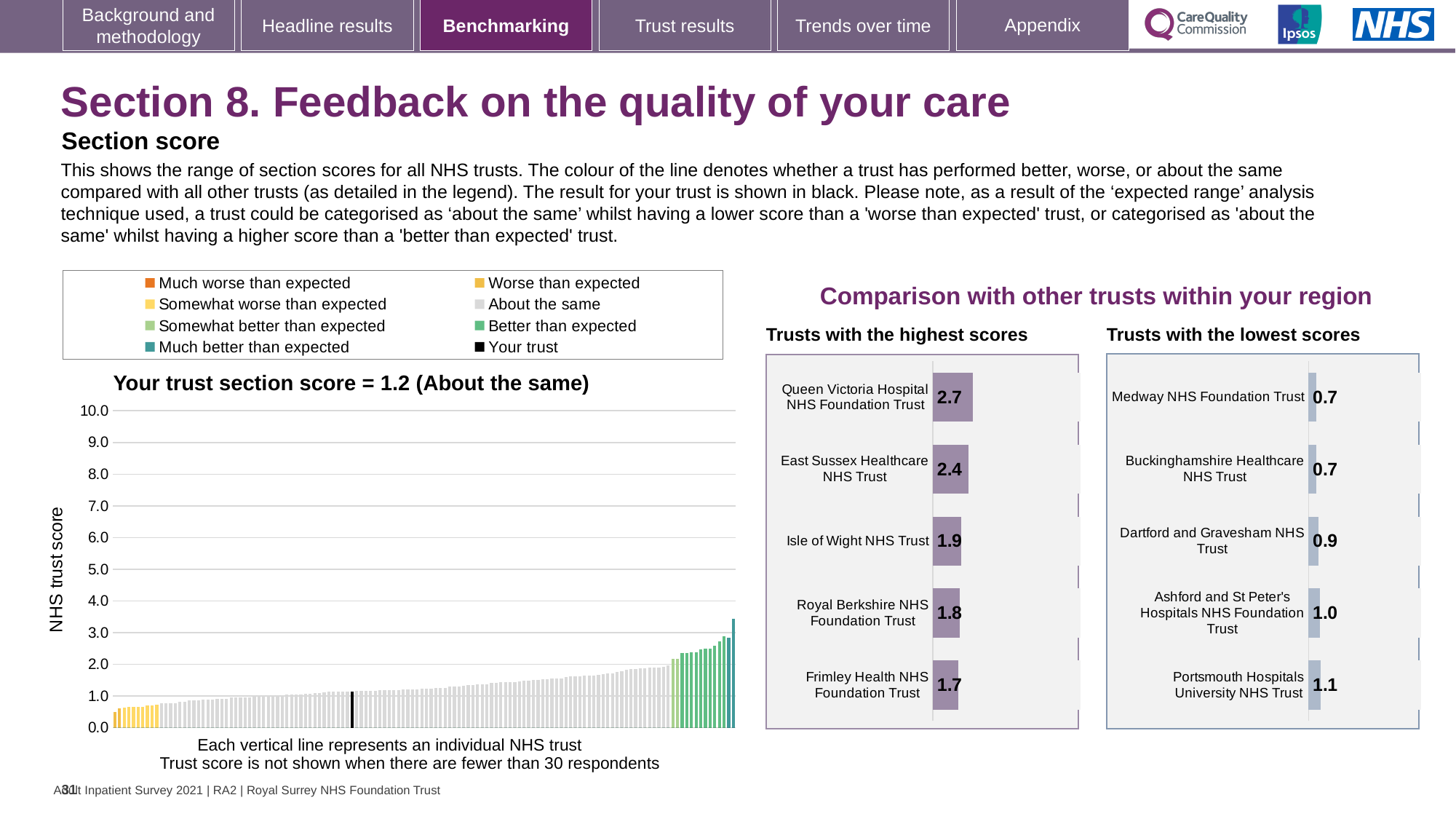
In the 'Trusts with the highest scores' chart, which trust has the highest score? Queen Victoria Hospital NHS Foundation Trust How many entries does the legend of the 'Your trust section score' chart list? 8 In the 'Trusts with the highest scores' chart, what is the difference between the scores of Queen Victoria Hospital NHS Foundation Trust and Frimley Health NHS Foundation Trust? 1.0 In the 'Trusts with the lowest scores' chart, what is the score for Dartford and Gravesham NHS Trust? 0.9 What kind of chart is the 'Your trust section score' chart? Bar chart In the 'Trusts with the lowest scores' chart, which has the larger score: Ashford and St Peter's Hospitals NHS Foundation Trust or Medway NHS Foundation Trust? Ashford and St Peter's Hospitals NHS Foundation Trust How many trusts are shown in the 'Trusts with the lowest scores' chart? 5 According to the title of the 'Your trust section score' chart, what is your trust's section score? 1.2 In the 'Trusts with the lowest scores' chart, which trust has the highest score? Portsmouth Hospitals University NHS Trust In the 'Trusts with the highest scores' chart, what is the score for Queen Victoria Hospital NHS Foundation Trust? 2.7 In the 'Your trust section score' chart, do the bars rise or fall from left to right? Rise In the 'Trusts with the highest scores' chart, what is the score for Isle of Wight NHS Trust? 1.9